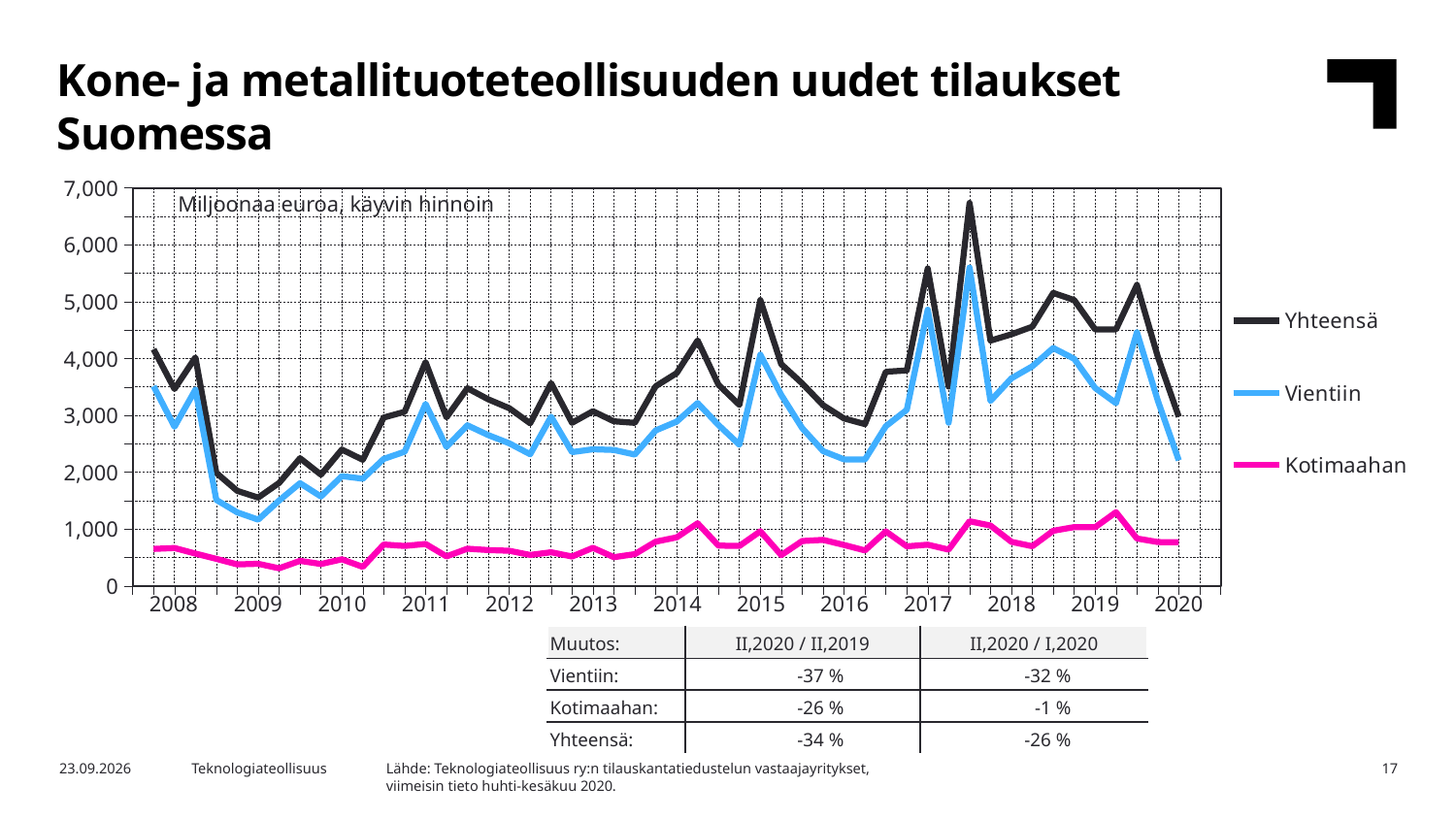
How many series does the legend list? 3 Is the Kotimaahan series ever greater or less than 2,000 across the whole chart? less How many years are labelled on the x axis? 13 Which series has the highest values throughout the chart? Yhteensä Does the Yhteensä series rise or fall from its 2017 peak to the end of 2020? fall Is the last plotted value of the Vientiin series in 2020 greater or less than 3,000? less Which series is larger in 2015, Vientiin or Kotimaahan? Vientiin What unit is stated in the text inside the chart area? Miljoonaa euroa, käyvin hinnoin Is the peak value of the Yhteensä series in 2017 greater or less than 6,000? greater What are the three series named in the legend? Yhteensä, Vientiin, Kotimaahan What kind of chart is shown on the slide? line chart Which series has the lowest values throughout the chart? Kotimaahan